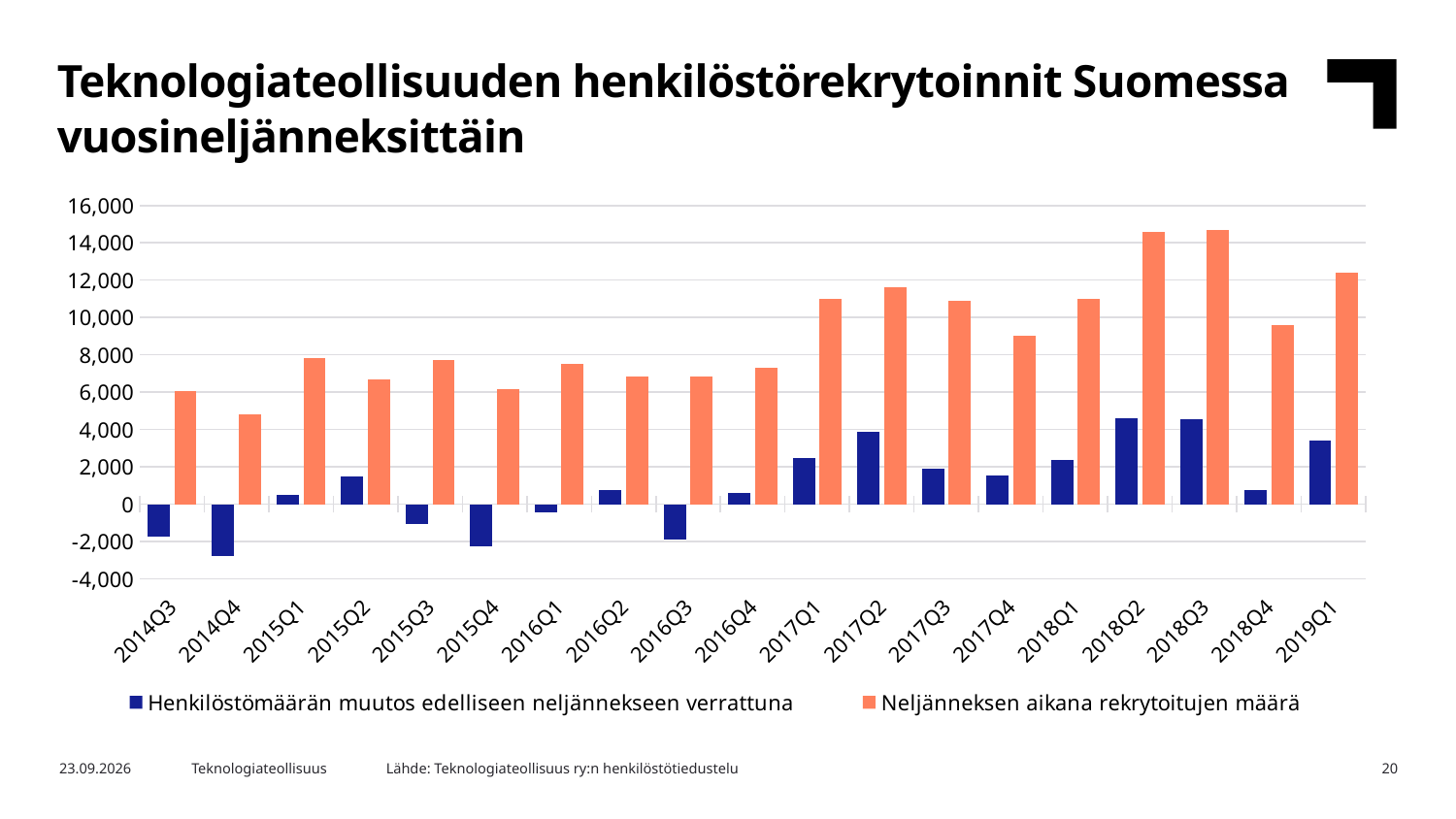
Which is larger for 'Neljänneksen aikana rekrytoitujen määrä': 2016Q4 or 2017Q1? 2017Q1 What kind of chart is shown on the slide? Bar chart How many quarters are shown on the x axis? 19 How many series does the legend list? 2 What colour are the bars for 'Neljänneksen aikana rekrytoitujen määrä'? Orange Overall, do the values for 'Neljänneksen aikana rekrytoitujen määrä' rise or fall from 2014Q3 to 2019Q1? rise Which quarter has the lowest value for 'Neljänneksen aikana rekrytoitujen määrä'? 2014Q4 Is the value for 'Henkilöstömäärän muutos edelliseen neljännekseen verrattuna' in 2017Q2 greater or less than 2,000? greater Is the value for 'Neljänneksen aikana rekrytoitujen määrä' in 2017Q2 greater or less than 10,000? greater Is the value for 'Neljänneksen aikana rekrytoitujen määrä' in 2017Q4 greater or less than 10,000? less